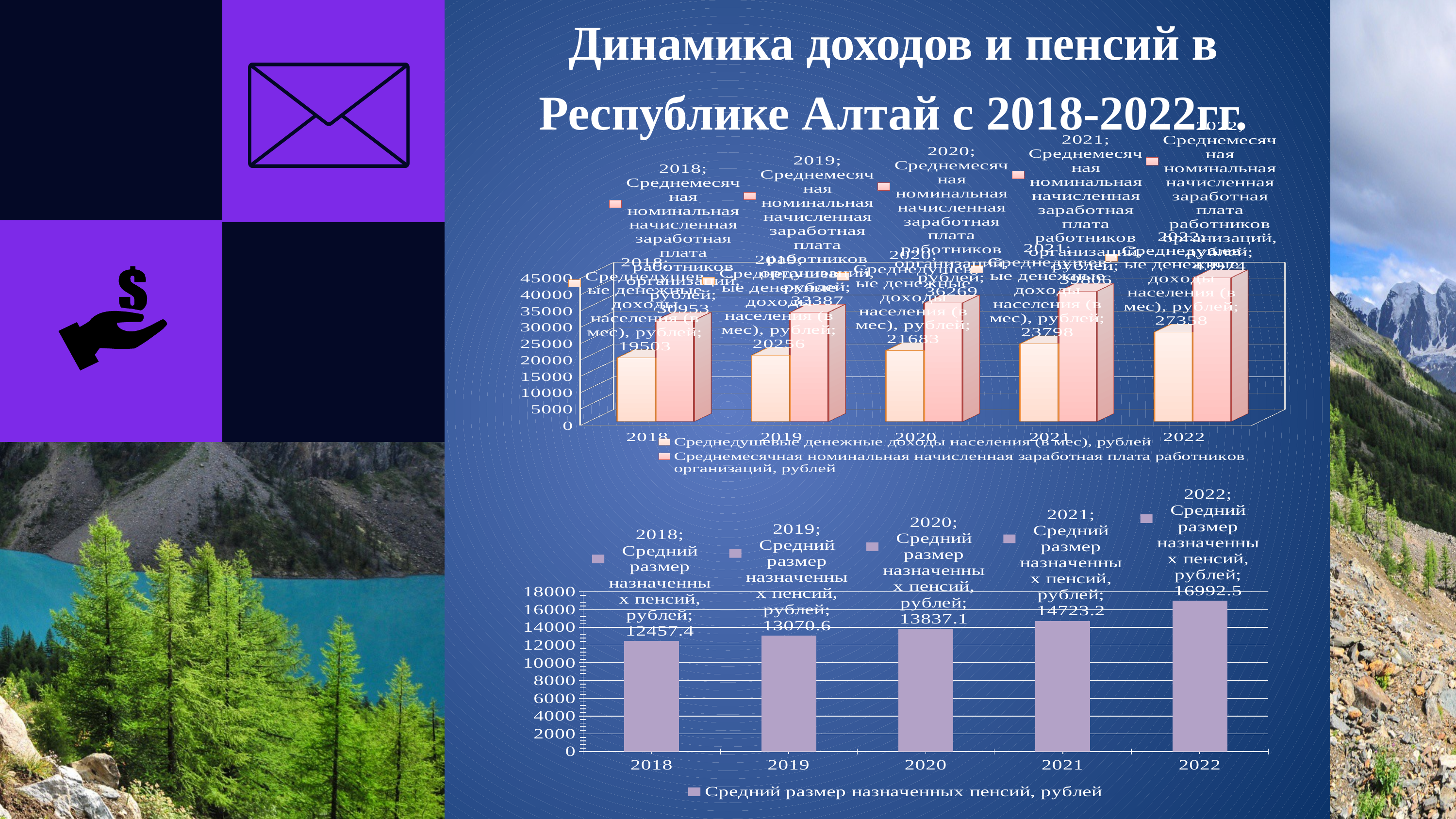
In the top chart, what is the difference between Среднедушевые денежные доходы населения in 2021 and in 2018? 4295 In the bottom chart (Средний размер назначенных пенсий), how many years are shown on the x axis? 5 What kind of chart is the bottom chart? bar chart In the bottom chart (Средний размер назначенных пенсий), what is the value for 2022? 16992.5 How many series does the legend of the top chart list? 2 In the bottom chart (Средний размер назначенных пенсий), what is the value for 2018? 12457.4 In the top chart, what is the value of Среднедушевые денежные доходы населения for 2022? 27358 In the bottom chart (Средний размер назначенных пенсий), which year has the lowest value? 2018 In the bottom chart (Средний размер назначенных пенсий), do the values rise or fall from 2018 to 2022? rise In the top chart, what is the value of Среднемесячная номинальная начисленная заработная плата for 2018? 30953 In the top chart, which is larger for 2020: Среднедушевые денежные доходы населения or Среднемесячная номинальная начисленная заработная плата? Среднемесячная номинальная начисленная заработная плата In the bottom chart (Средний размер назначенных пенсий), what is the difference between the 2021 and 2020 values? 886.1